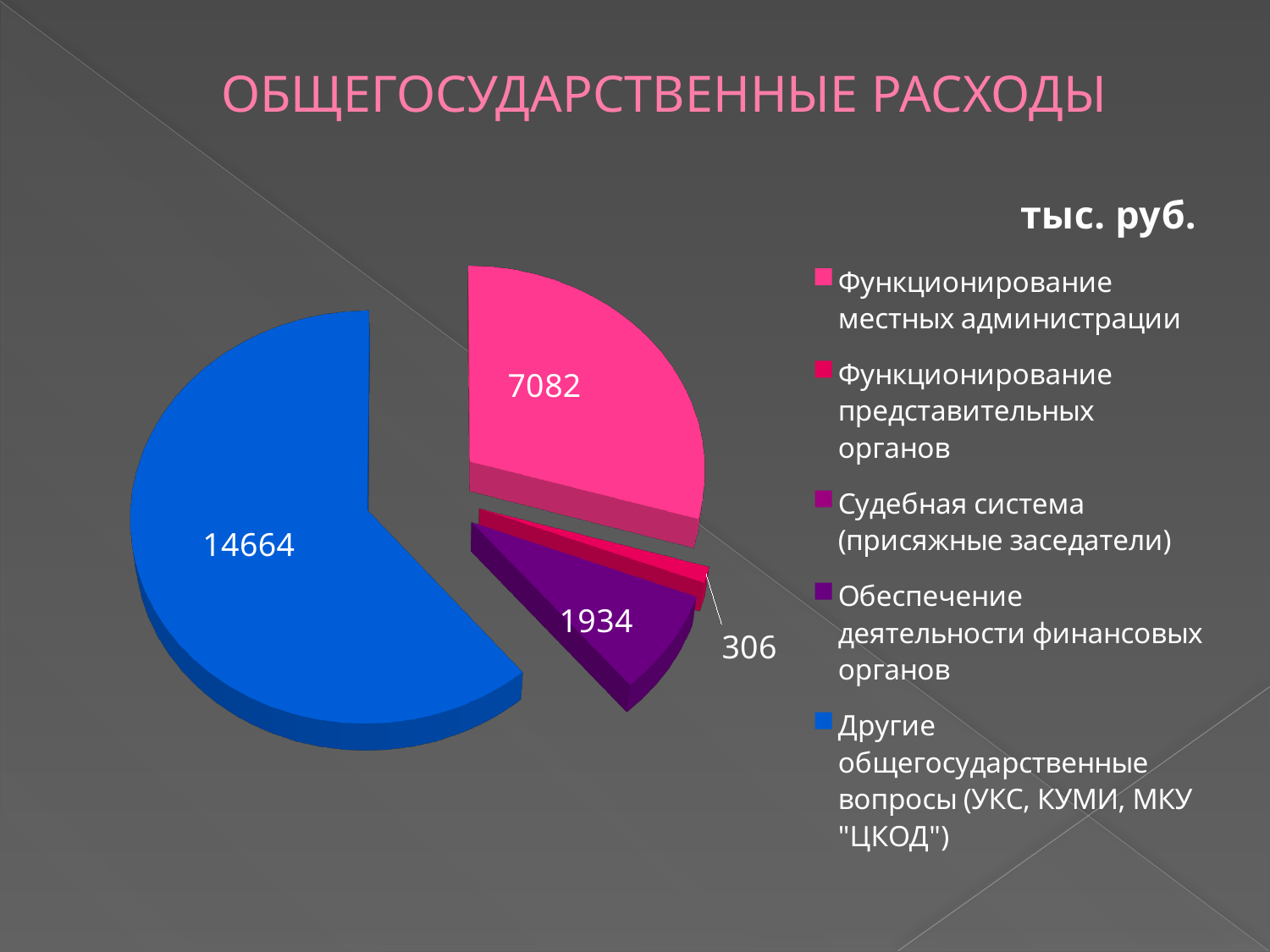
What is the value for Другие общегосударственные вопросы (УКС, КУМИ, МКУ "ЦКОД")? 14664 What is the value for Функционирование местных администрации? 7082 How many entries does the legend list? 5 What is the value for Обеспечение деятельности финансовых органов? 1934 What type of chart is shown on the slide? Pie chart In what units are the chart values given? тыс. руб. What is the difference between the values for Другие общегосударственные вопросы and Функционирование местных администрации? 7582 What is the value for Функционирование представительных органов? 306 Which category has the largest slice of the pie? Другие общегосударственные вопросы (УКС, КУМИ, МКУ "ЦКОД") Which is larger: Обеспечение деятельности финансовых органов or Функционирование представительных органов? Обеспечение деятельности финансовых органов What is the difference between the values for Функционирование местных администрации and Обеспечение деятельности финансовых органов? 5148 Which category has the smallest printed value on the chart? Функционирование представительных органов